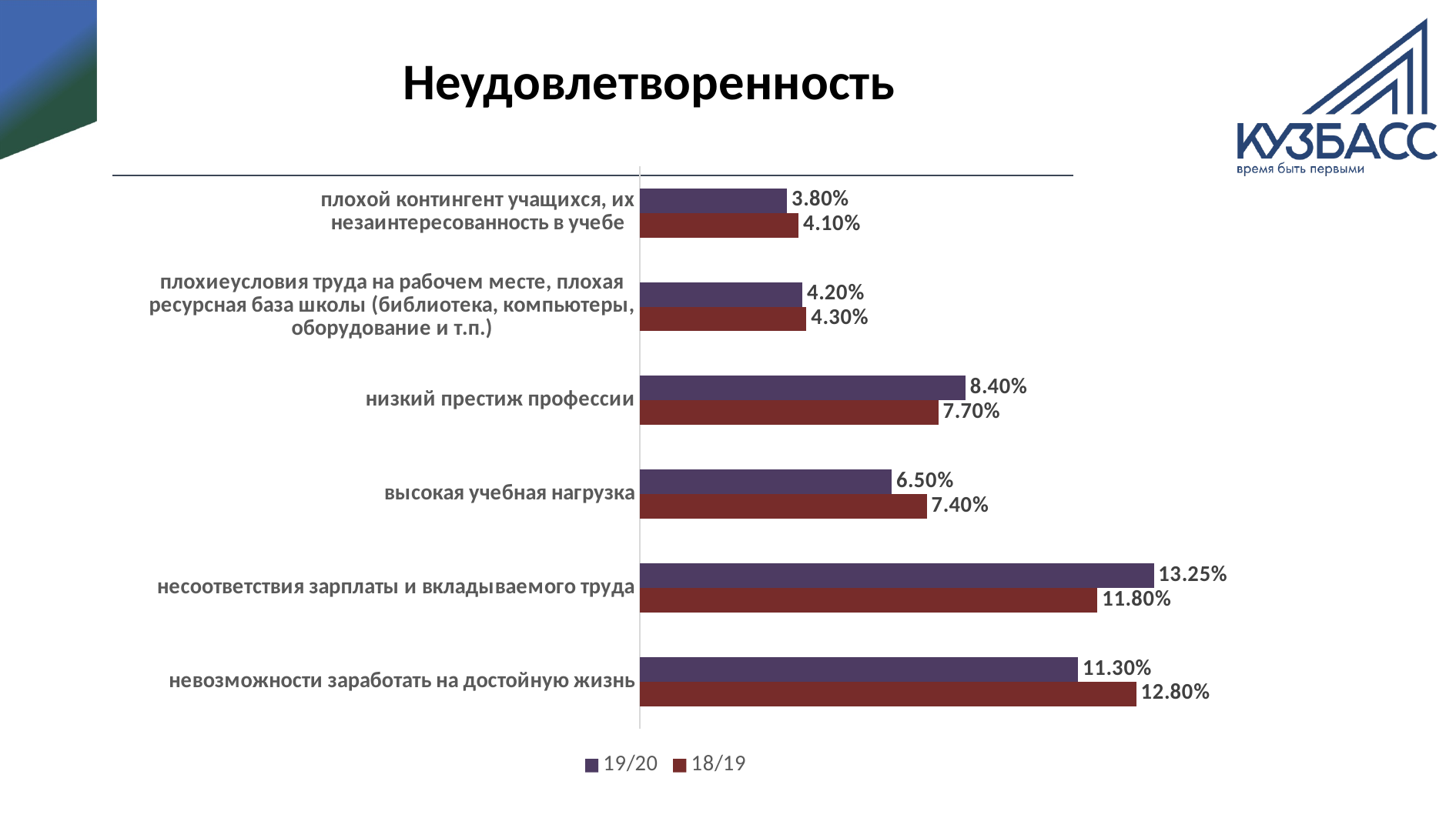
For "низкий престиж профессии", which series has the larger value, 19/20 or 18/19? 19/20 What is the difference between the 18/19 and 19/20 values for "невозможности заработать на достойную жизнь"? 1.50% What is the value for "высокая учебная нагрузка" in the 18/19 series? 7.40% What is the difference between the 19/20 and 18/19 values for "несоответствия зарплаты и вкладываемого труда"? 1.45% For "высокая учебная нагрузка", which series has the larger value, 19/20 or 18/19? 18/19 What is the value for "низкий престиж профессии" in the 19/20 series? 8.40% How many series does the legend list? 2 How many categories are shown in the chart? 6 What type of chart is shown on the slide? Bar chart Which category has the lowest value in the 18/19 series? плохой контингент учащихся, их незаинтересованность в учебе What is the 18/19 value for "плохой контингент учащихся, их незаинтересованность в учебе"? 4.10% Which category has the highest value in the 19/20 series? несоответствия зарплаты и вкладываемого труда